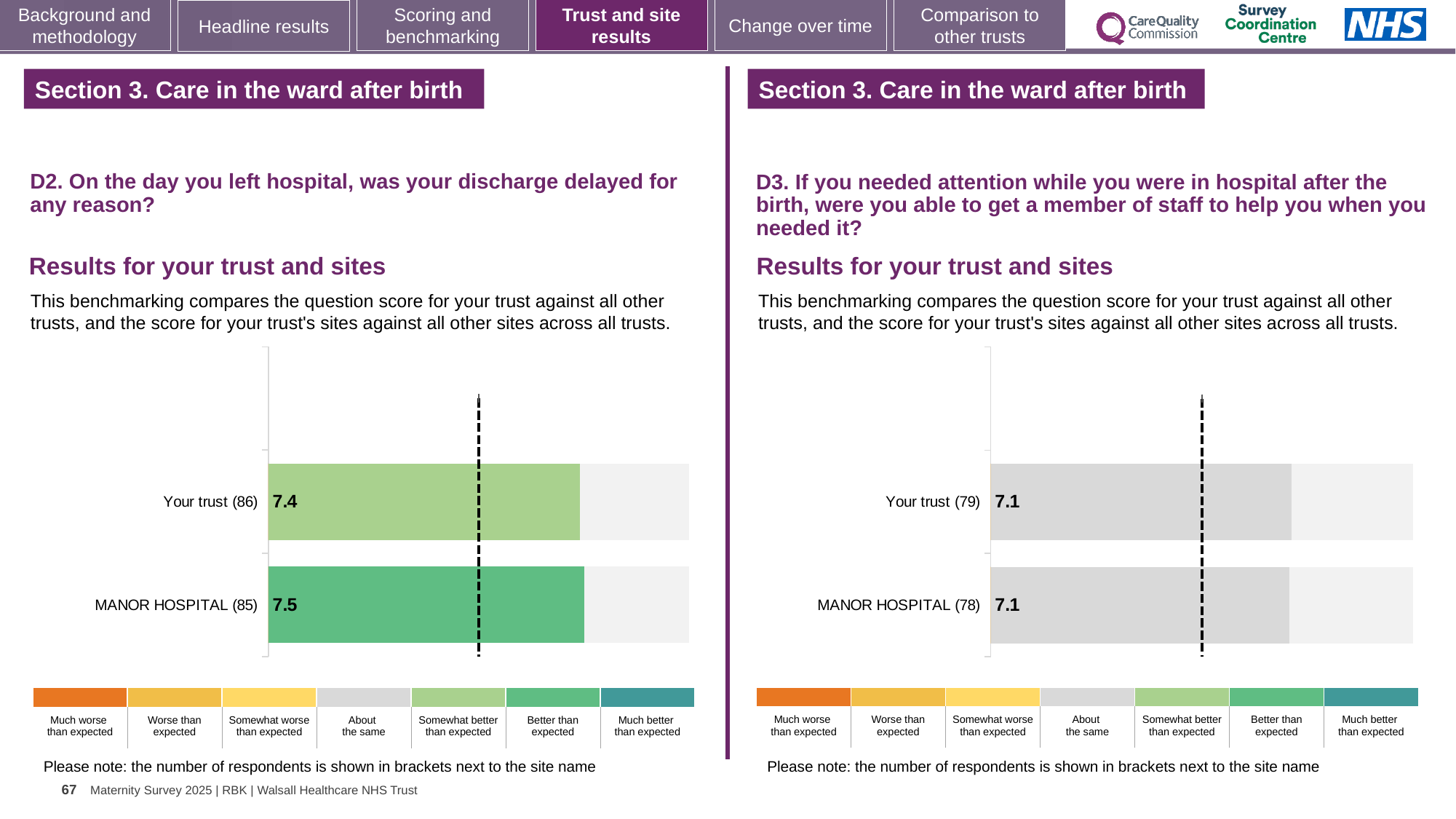
In the D3 chart on the right, how many respondents are shown in brackets for MANOR HOSPITAL? 78 In the D2 chart on the left, what is the difference between the MANOR HOSPITAL score and the Your trust score? 0.1 In the D3 chart on the right, which benchmark category does the colour of the Your trust bar correspond to? About the same In the D3 chart on the right, what is the difference between the Your trust score and the MANOR HOSPITAL score? 0 How many bars are shown in the D2 chart on the left? 2 In the D2 chart on the left, which has the higher score, Your trust or MANOR HOSPITAL? MANOR HOSPITAL What type of chart is used for the D3 results on the right? Bar chart In the D3 chart on the right, what is the score for MANOR HOSPITAL? 7.1 In the D2 chart on the left, what is the score for Your trust? 7.4 In the D2 chart on the left, what is the score for MANOR HOSPITAL? 7.5 In the D3 chart on the right, what is the score for Your trust? 7.1 In the D2 chart on the left, how many respondents are shown in brackets for Your trust? 86